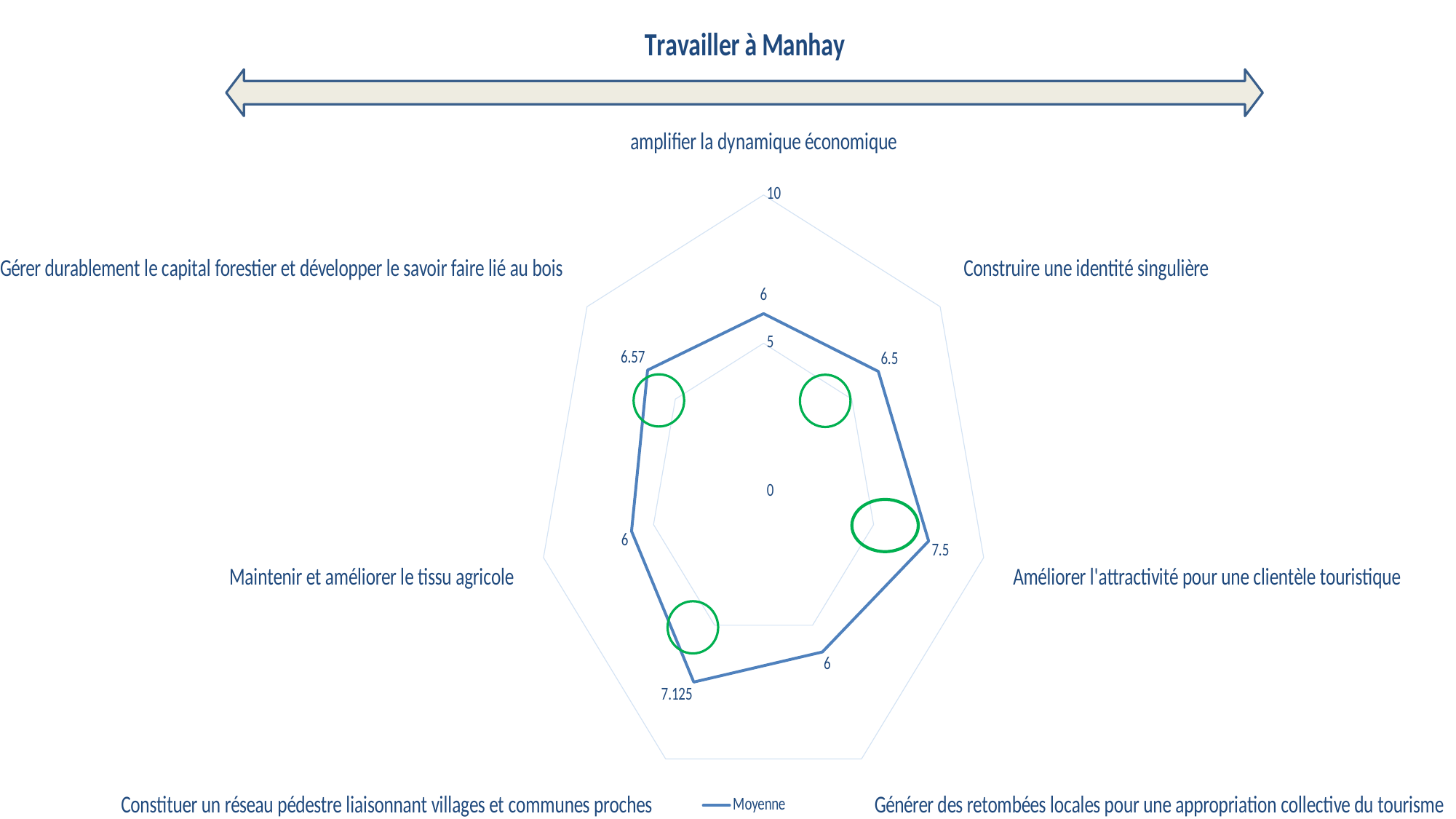
What is the name of the series shown in the legend? Moyenne What is the value for "Construire une identité singulière"? 6.5 Which is larger, the value for "Constituer un réseau pédestre liaisonnant villages et communes proches" or the value for "Construire une identité singulière"? Constituer un réseau pédestre liaisonnant villages et communes proches What is the value for "amplifier la dynamique économique"? 6 What is the value for "Constituer un réseau pédestre liaisonnant villages et communes proches"? 7.125 How many categories (axes) does the chart have? 7 What kind of chart is shown on the slide? Radar chart Which category has the highest value? Améliorer l'attractivité pour une clientèle touristique What is the value for "Gérer durablement le capital forestier et développer le savoir faire lié au bois"? 6.57 How many series does the legend list? 1 What is the difference between the values for "Améliorer l'attractivité pour une clientèle touristique" and "Maintenir et améliorer le tissu agricole"? 1.5 What is the value for "Améliorer l'attractivité pour une clientèle touristique"? 7.5